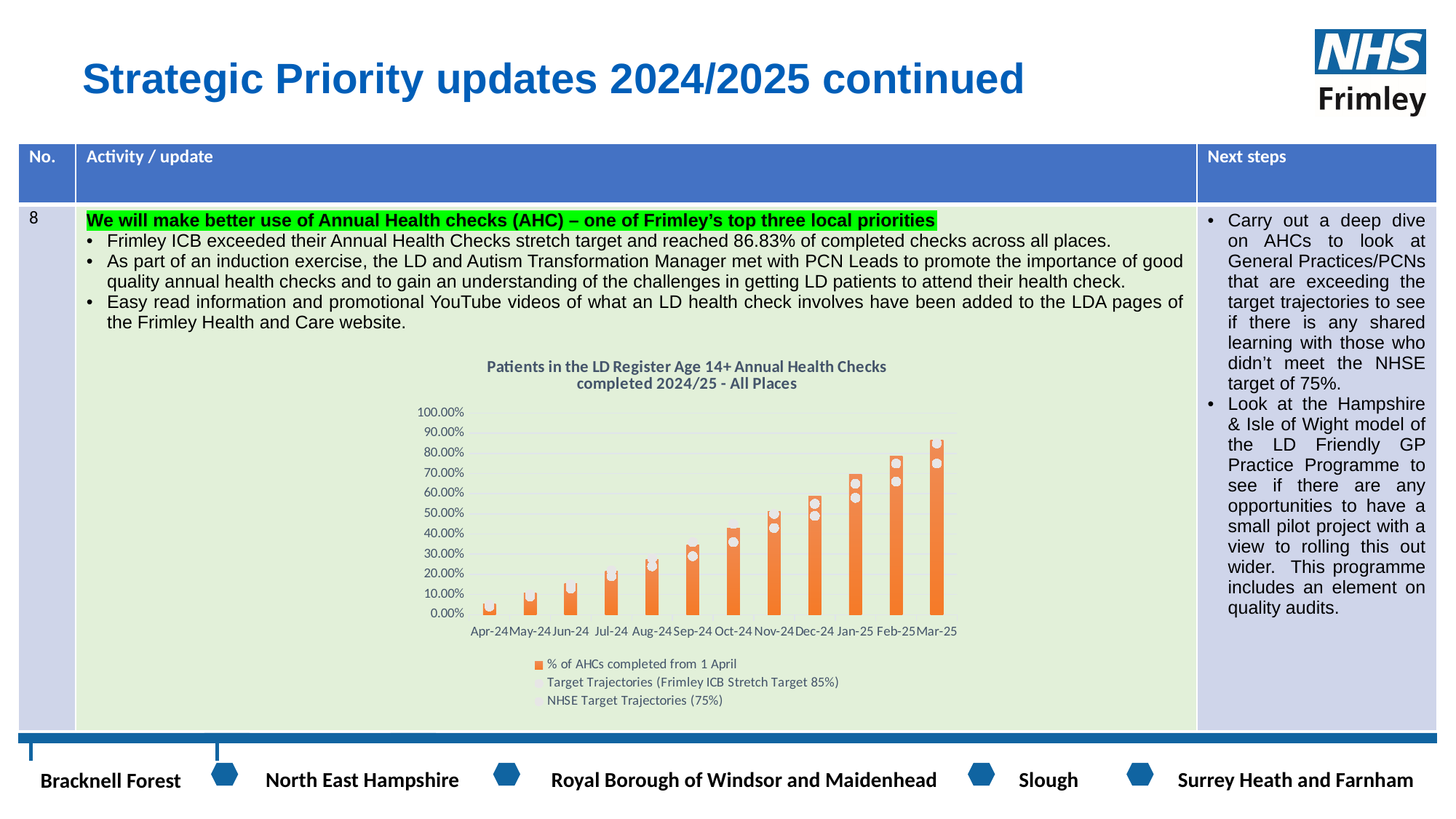
Is the % of AHCs completed from 1 April for Mar-25 greater or less than 80.00%? greater What kind of chart is shown on the slide? bar chart Which month has the lowest % of AHCs completed from 1 April? Apr-24 Do the % of AHCs completed from 1 April values rise or fall from Apr-24 to Mar-25? rise Which month has a larger % of AHCs completed from 1 April, Dec-24 or Aug-24? Dec-24 Is the % of AHCs completed from 1 April for Jan-25 greater or less than 60.00%? greater Which month has the highest % of AHCs completed from 1 April? Mar-25 Is the % of AHCs completed from 1 April for Apr-24 greater or less than 10.00%? less How many months are shown on the x axis of the chart? 12 How many series does the chart legend list? 3 What is the title of the chart? Patients in the LD Register Age 14+ Annual Health Checks completed 2024/25 - All Places